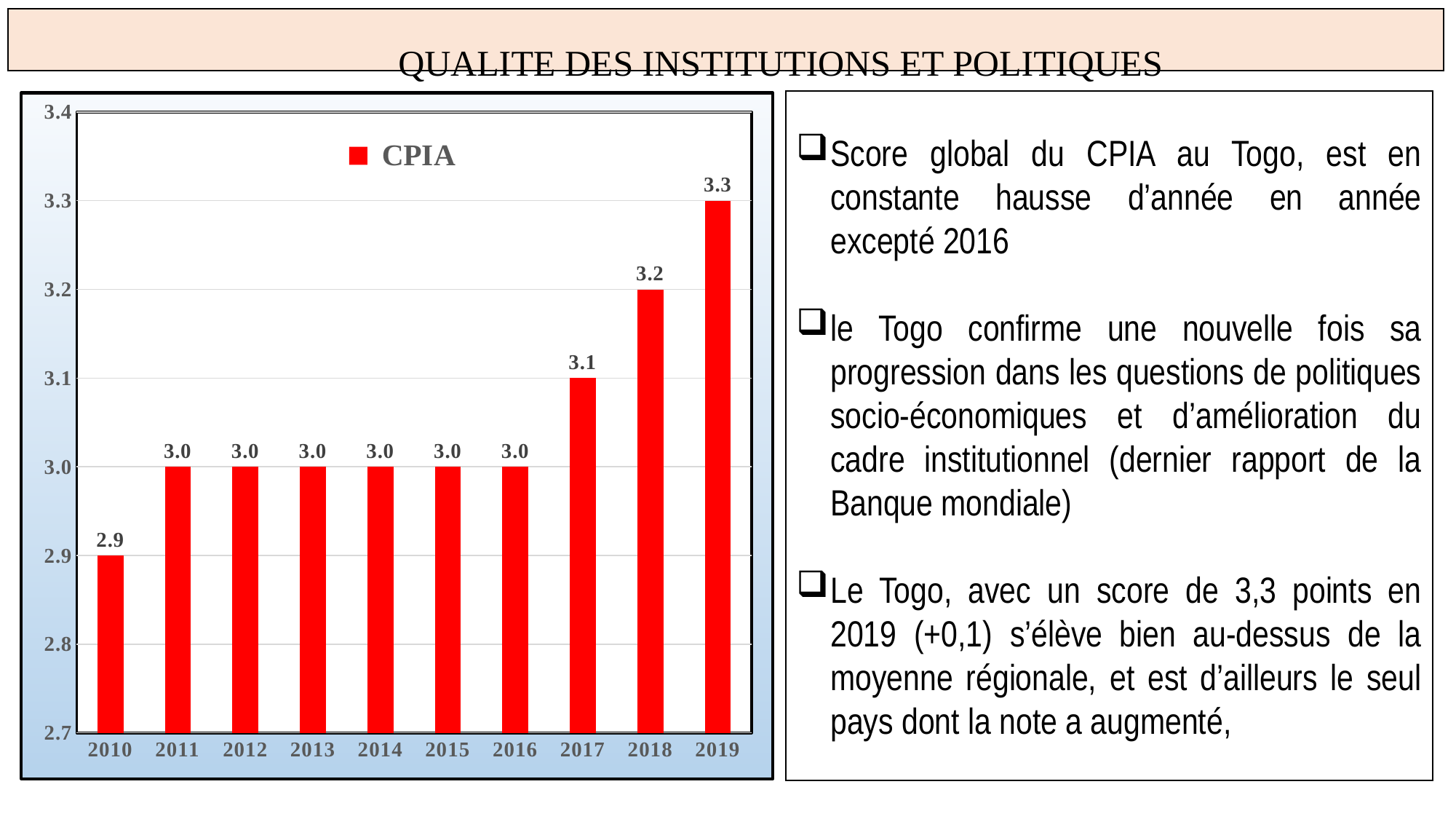
What is the CPIA value for 2010? 2.9 How many series does the legend list? 1 What kind of chart is shown on the slide? bar chart What is the CPIA value for 2017? 3.1 Which is larger, the CPIA value for 2018 or for 2017? 2018 What is the CPIA value for 2019? 3.3 Which year has the lowest CPIA value? 2010 Which year has the highest CPIA value? 2019 What is the difference between the CPIA values for 2019 and 2010? 0.4 What is the name of the series shown in the legend? CPIA Do the CPIA values generally rise or fall from 2010 to 2019? rise How many years are shown on the x axis? 10